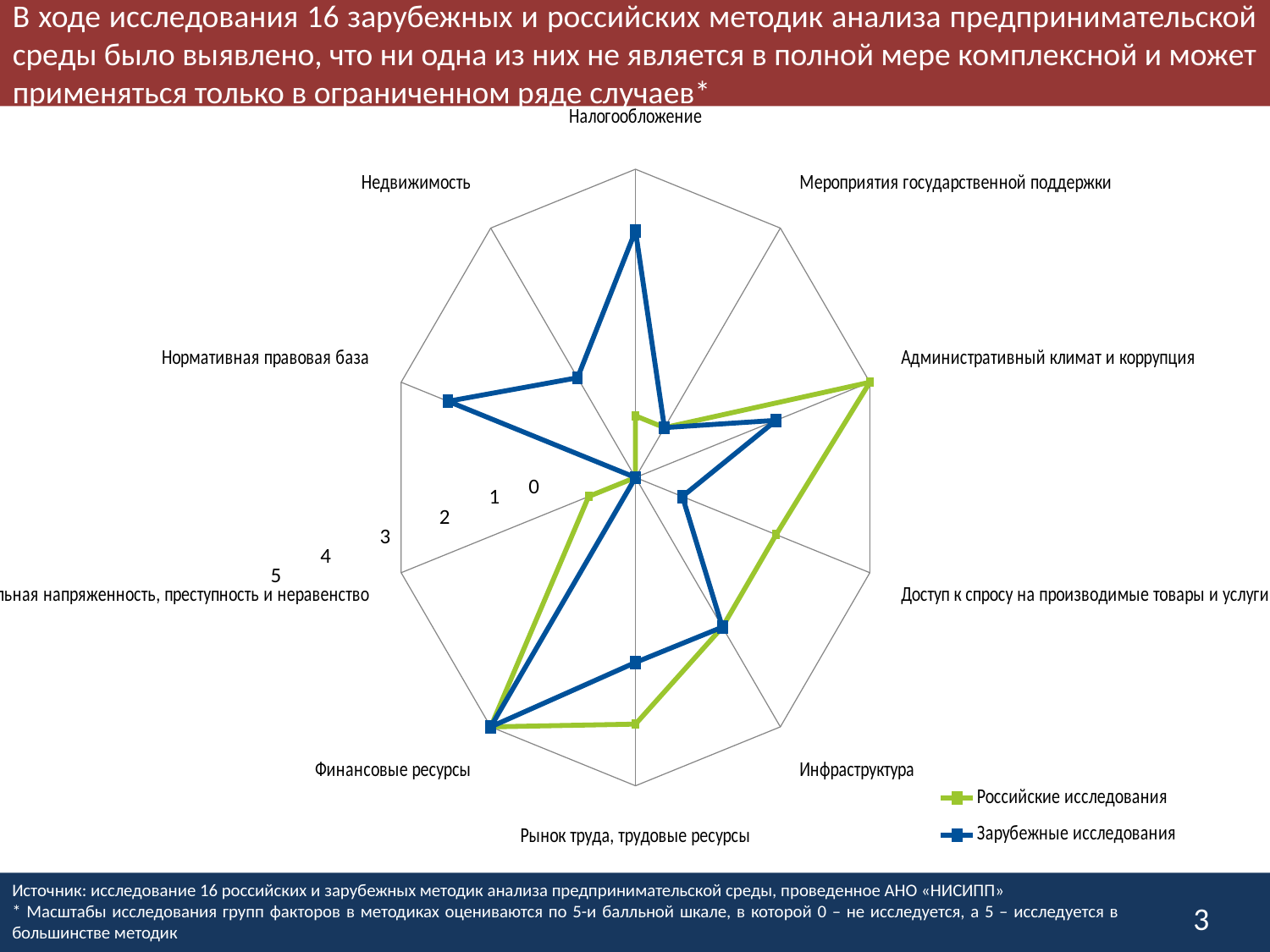
What kind of chart is shown on the slide? Radar chart For Административный климат и коррупция, which series has the larger value? Российские исследования How many series does the legend list? 2 In the Зарубежные исследования series, which category has the highest value? Финансовые ресурсы What is the highest value shown on the chart's scale? 5 How many categories (axes) does the radar chart have? 10 Is the value for Налогообложение in the Российские исследования series greater or less than 2? less Which series is drawn in green? Российские исследования Is the value for Доступ к спросу на производимые товары и услуги in the Зарубежные исследования series greater or less than 2? less For Нормативная правовая база, which series has the larger value? Зарубежные исследования Is the value for Налогообложение in the Зарубежные исследования series greater or less than 3? greater